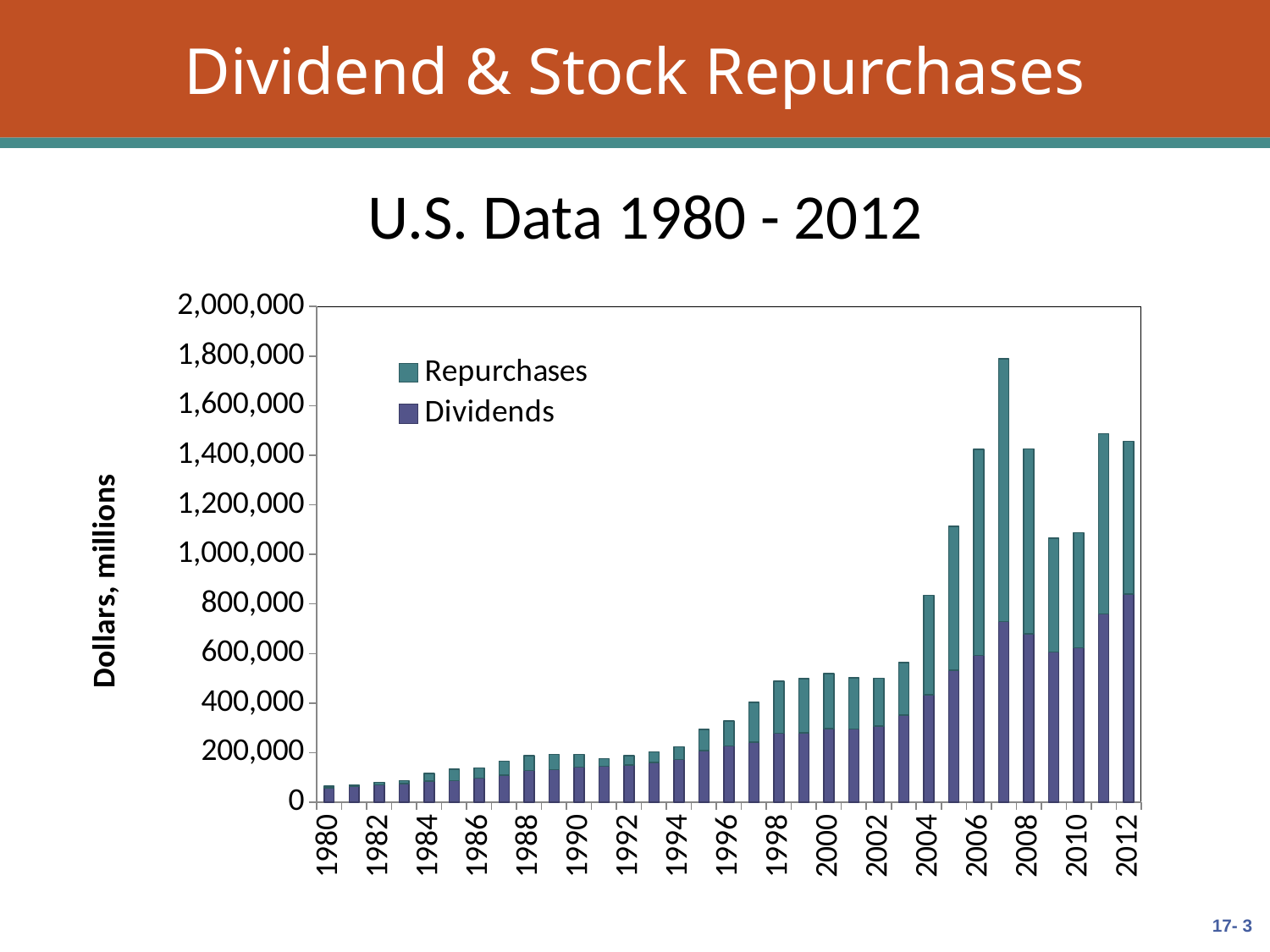
How many years (bars) are plotted in the chart? 33 Which year has the larger total, 2007 or 2008? 2007 Is the total for 2007 greater or less than 1,600,000? greater What is the label on the vertical axis? Dollars, millions Which two series are listed in the legend? Repurchases and Dividends Which year has the highest total of dividends and repurchases? 2007 Is the total for 2009 greater or less than 1,200,000? less What kind of chart is shown on the slide? Stacked bar chart Is the total for 2005 greater or less than 1,000,000? greater Do the totals generally rise or fall from 1980 to 2007? rise How many series does the legend list? 2